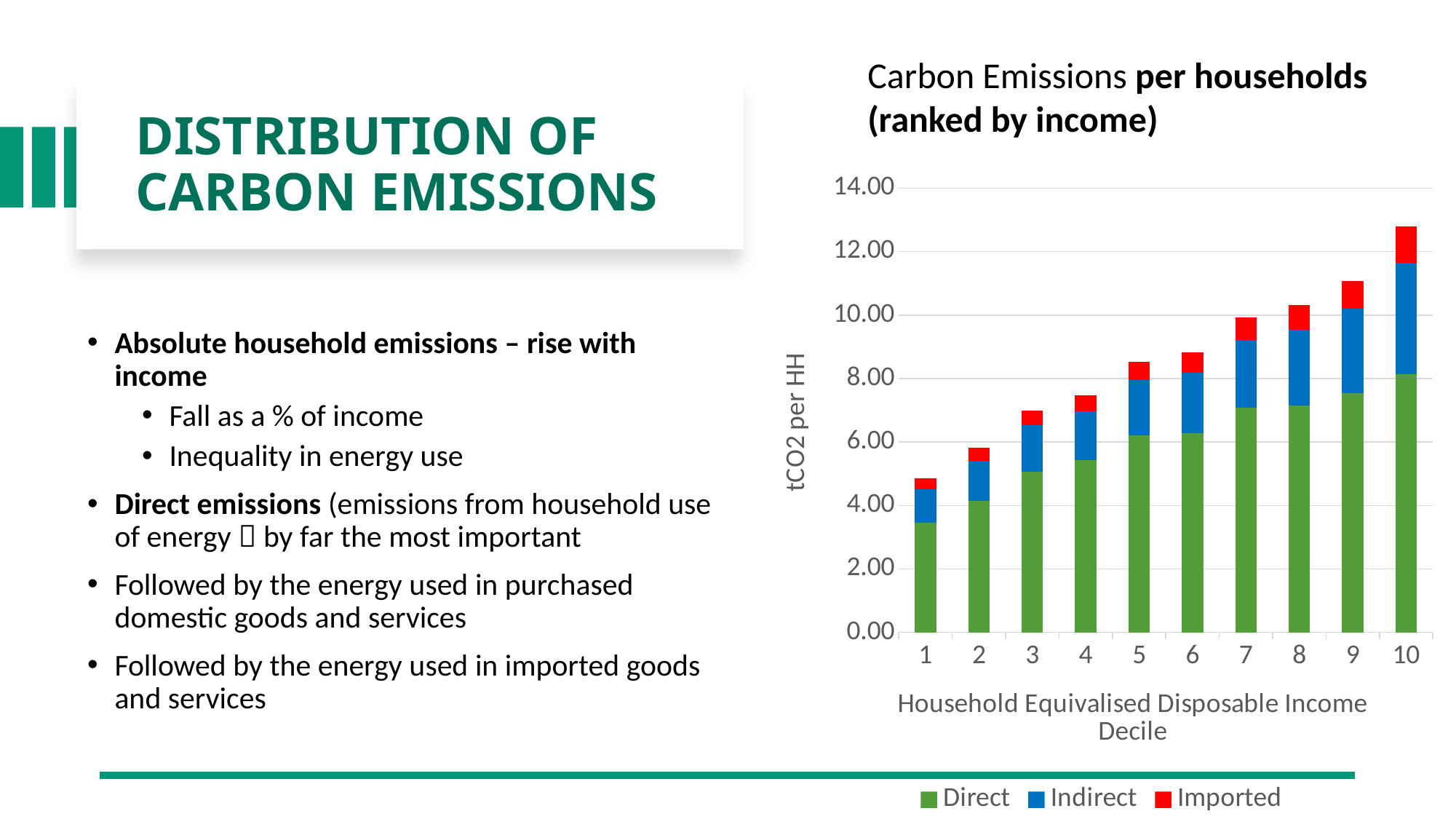
What is the label on the y axis of the chart? tCO2 per HH Which income decile has the highest total carbon emissions per household? 10 Is the total value for decile 5 greater or less than 8.00? greater Which income decile has the lowest total carbon emissions per household? 1 What kind of chart is shown on the slide? Stacked bar chart Is the total value for decile 3 greater or less than 8.00? less How many series does the legend list? 3 Which series is shown in green in the chart? Direct Is the total value for decile 10 greater or less than 12.00? greater How many income deciles are plotted on the x axis? 10 Do total carbon emissions per household rise or fall as the income decile increases from 1 to 10? Rise